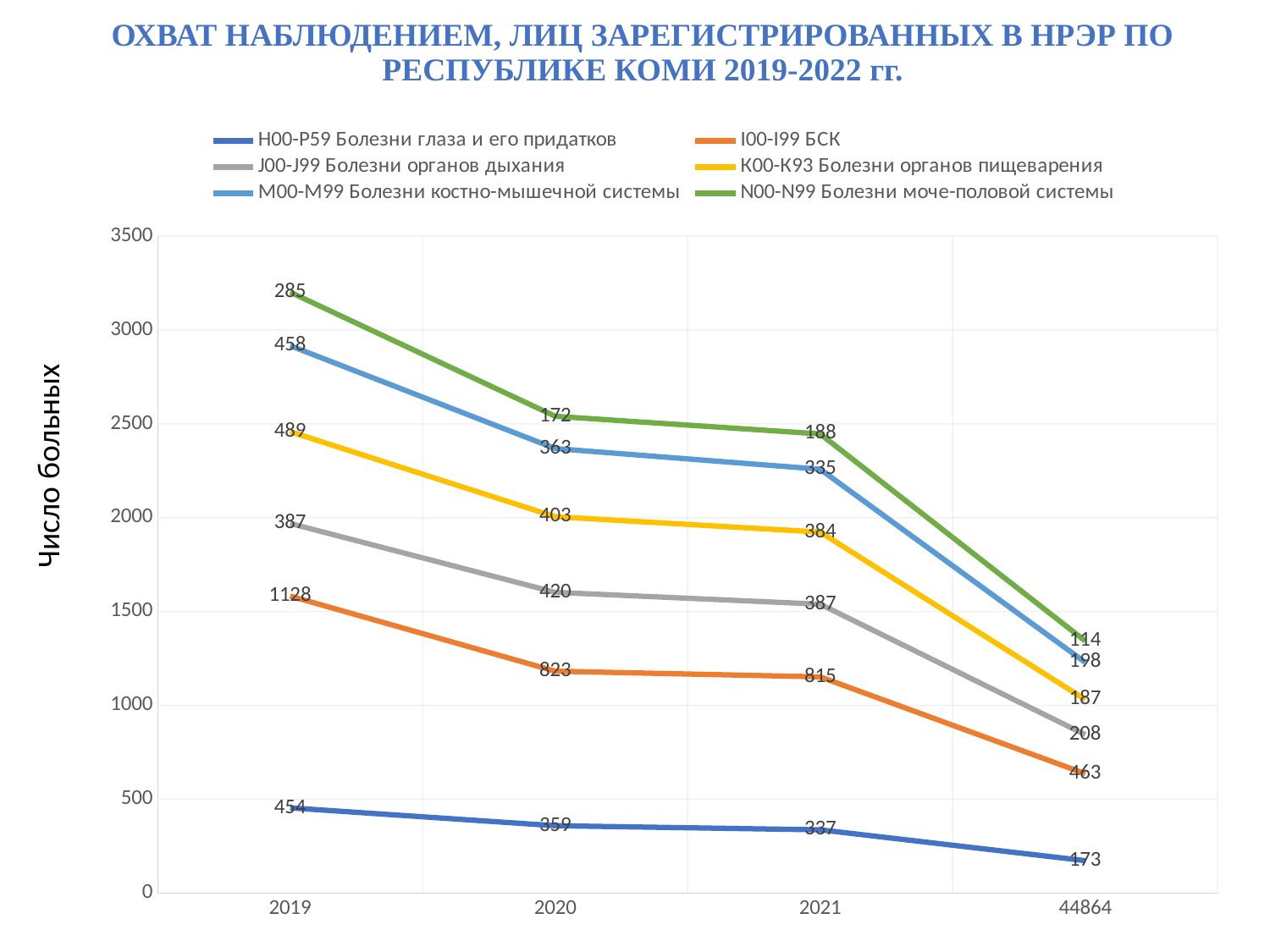
What is the value labelled for N00-N99 Болезни моче-половой системы in 2019? 285 How many series does the legend list? 6 What is the value labelled for K00-K93 Болезни органов пищеварения at the x-axis point 44864? 187 Which series has the lowest labelled value at the x-axis point 44864? N00-N99 Болезни моче-половой системы Do the labelled values for I00-I99 БСК rise or fall from 2019 to the last point on the x axis? fall What is the value labelled for H00-P59 Болезни глаза и его придатков in 2019? 454 How many points are plotted along the x axis for each series? 4 What is the value labelled for J00-J99 Болезни органов дыхания in 2021? 387 What kind of chart is shown on the slide? line chart What is the difference between the labelled values for H00-P59 Болезни глаза и его придатков in 2019 and at the x-axis point 44864? 281 What is the value labelled for I00-I99 БСК in 2020? 823 Which series has the highest labelled value in 2019? I00-I99 БСК